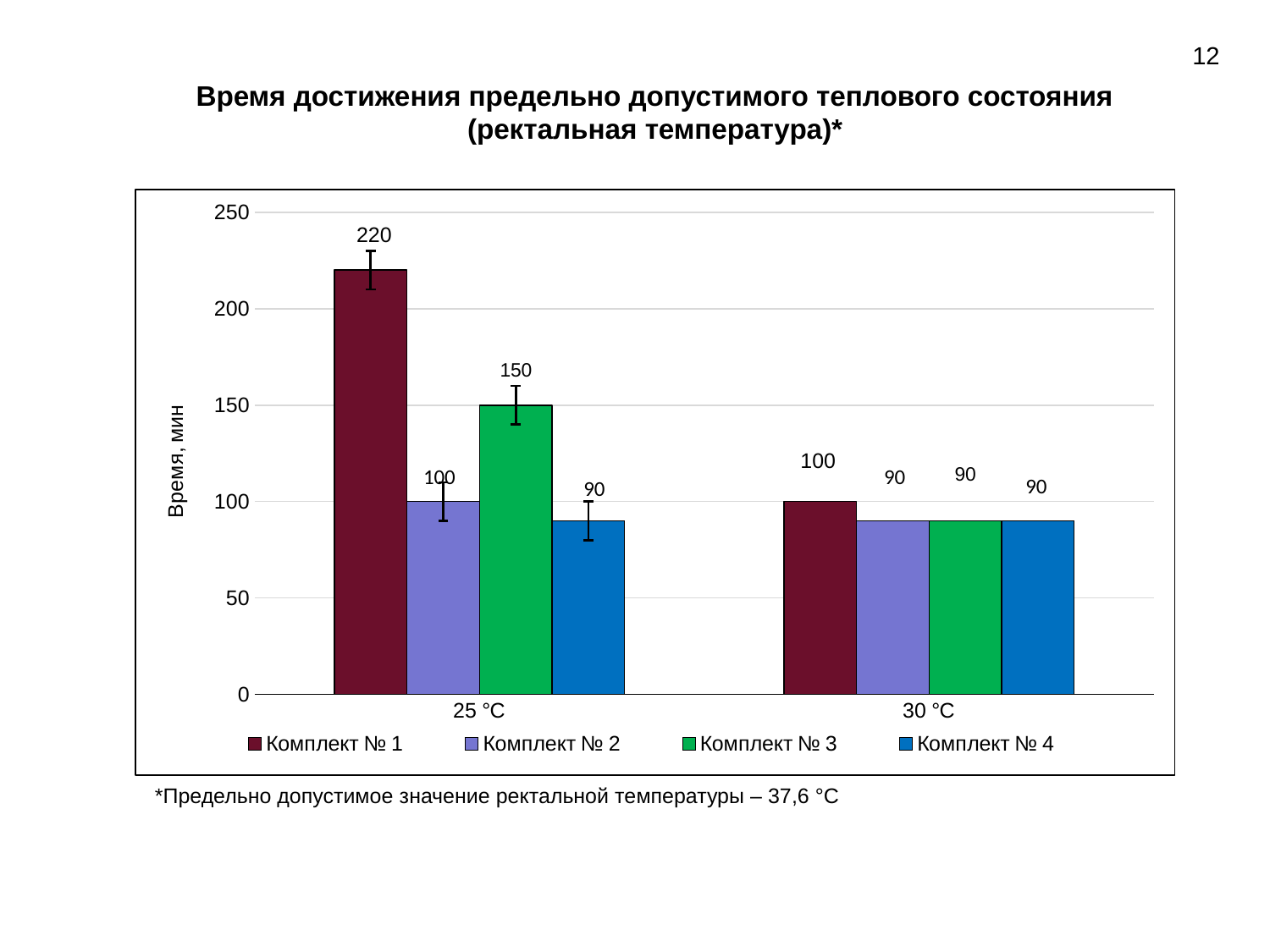
What is the value for Комплект № 1 at 30 °C? 100 Which is larger: Комплект № 2 at 25 °C or Комплект № 3 at 25 °C? Комплект № 3 at 25 °C How many categories are shown on the x axis? 2 What is the difference between Комплект № 1 at 25 °C and Комплект № 1 at 30 °C? 120 Which series has the lowest value at 25 °C? Комплект № 4 What is the value for Комплект № 3 at 25 °C? 150 What is the difference between Комплект № 1 and Комплект № 3 at 25 °C? 70 What kind of chart is shown on the slide? Bar chart What is the value for Комплект № 4 at 30 °C? 90 Which series has the highest value at 25 °C? Комплект № 1 What is the value for Комплект № 1 at 25 °C? 220 How many series does the legend list? 4